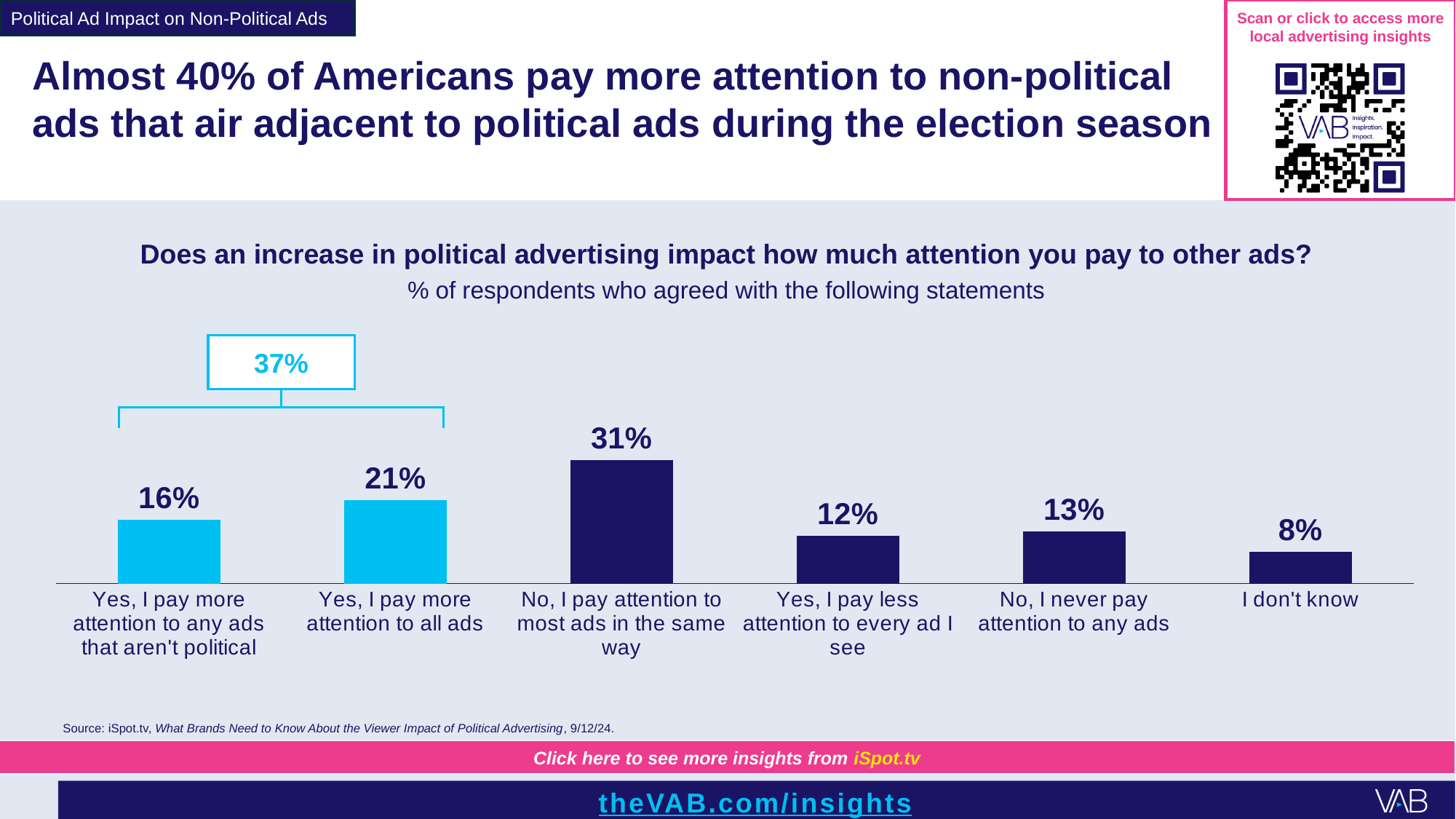
What percentage of respondents agreed with "Yes, I pay more attention to any ads that aren't political"? 16% Which is larger: "No, I never pay attention to any ads" or "Yes, I pay less attention to every ad I see"? No, I never pay attention to any ads Which statement had the highest share of respondents agreeing? No, I pay attention to most ads in the same way What combined percentage is shown in the box above the two light blue bars? 37% What is the difference between "Yes, I pay more attention to all ads" and "Yes, I pay less attention to every ad I see"? 9% How many response categories are shown in the chart? 6 What percentage of respondents answered "I don't know"? 8% Which statement had the lowest share of respondents agreeing? I don't know What is the question shown as the chart's title? Does an increase in political advertising impact how much attention you pay to other ads? What type of chart is shown on the slide? Bar chart What percentage of respondents agreed with "No, I pay attention to most ads in the same way"? 31% What percentage of respondents agreed with "No, I never pay attention to any ads"? 13%